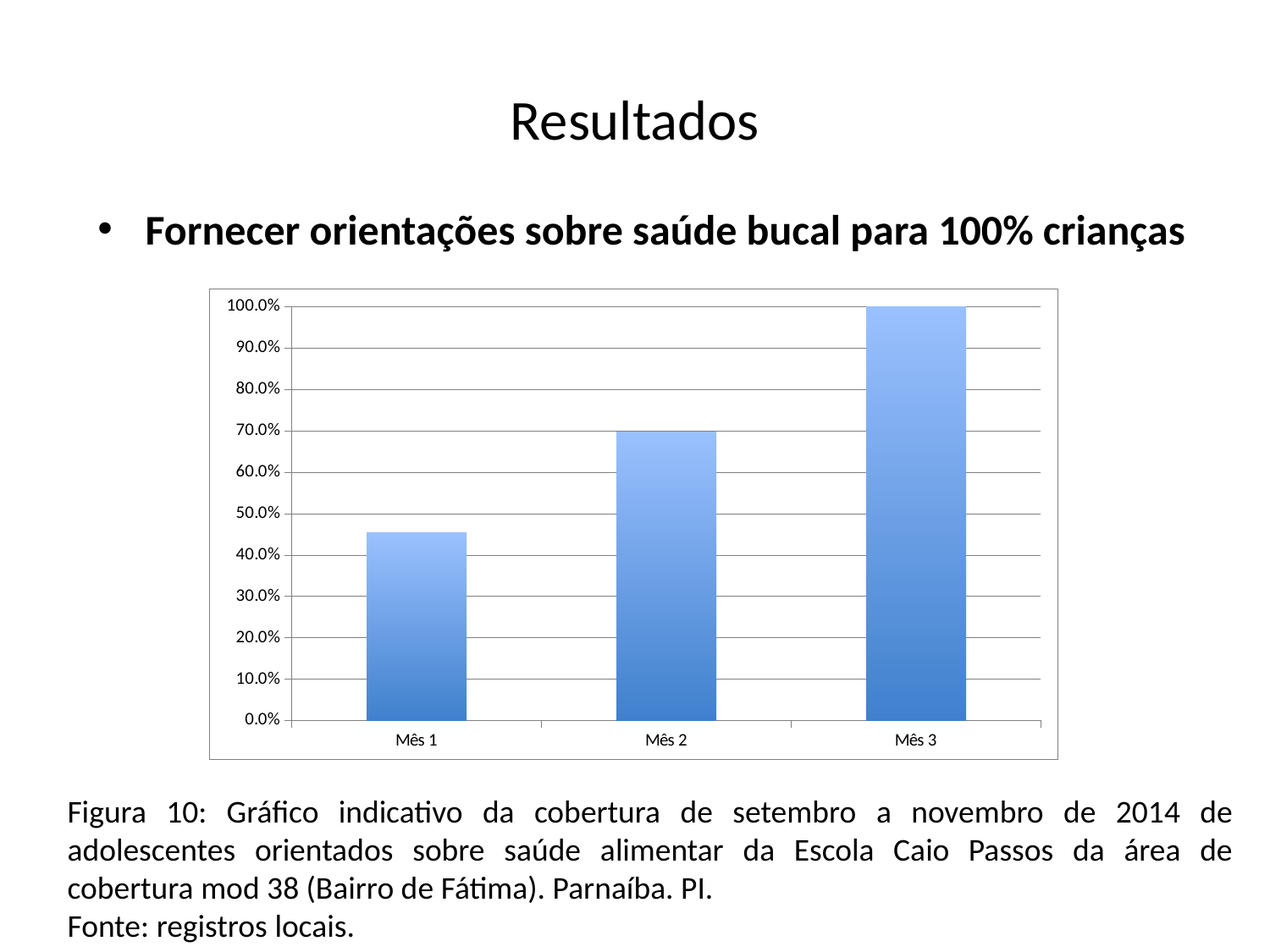
What kind of chart is shown on the slide? bar chart What is the value for Mês 3 in the chart? 100.0% Do the values rise or fall from Mês 1 to Mês 3? rise What is the label of the first category on the x axis of the chart? Mês 1 Which month has the highest value in the chart? Mês 3 Which month has the lowest value in the chart? Mês 1 Is the value for Mês 1 greater or less than 50.0%? less How many months (categories) are plotted on the x axis of the chart? 3 Is the value for Mês 1 greater or less than 40.0%? greater Which is larger, the value for Mês 2 or the value for Mês 1? Mês 2